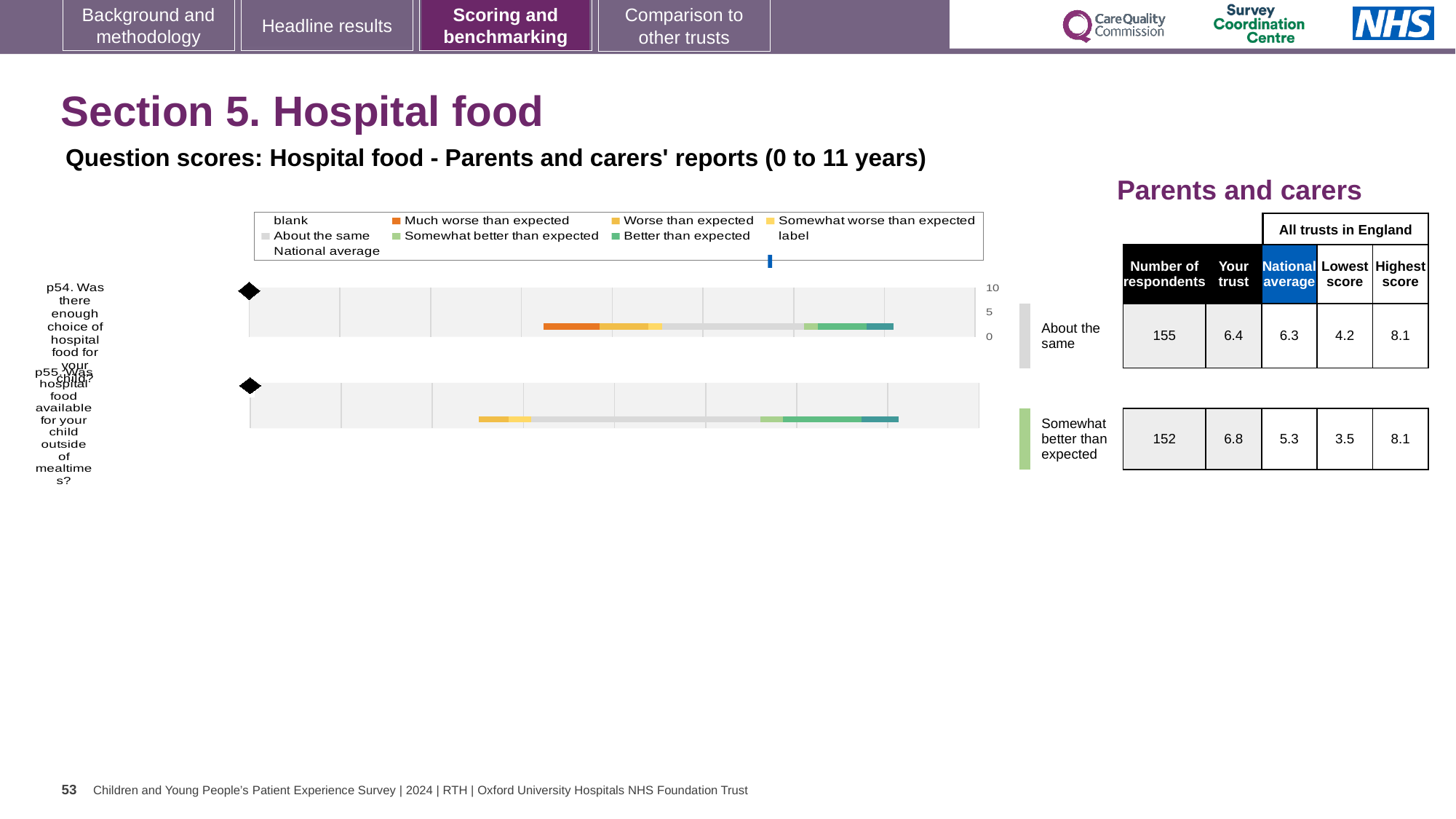
Which benchmark category is p55 placed in? Somewhat better than expected What kind of chart is used to show the question scores for hospital food? bar chart What is the 'Your trust' score for p55 (hospital food available outside of mealtimes)? 6.8 How many respondents answered p54? 155 What is the national average score for p54? 6.3 How many entries does the legend of the hospital food chart list? 9 How many questions (rows) are plotted in the hospital food chart? 2 What is the 'Your trust' score for p54 (enough choice of hospital food for your child)? 6.4 What is the national average score for p55? 5.3 What is the lowest score across all trusts in England for p55? 3.5 Which question has the higher 'Your trust' score, p54 or p55? p55 What is the difference between the 'Your trust' score and the national average for p55? 1.5